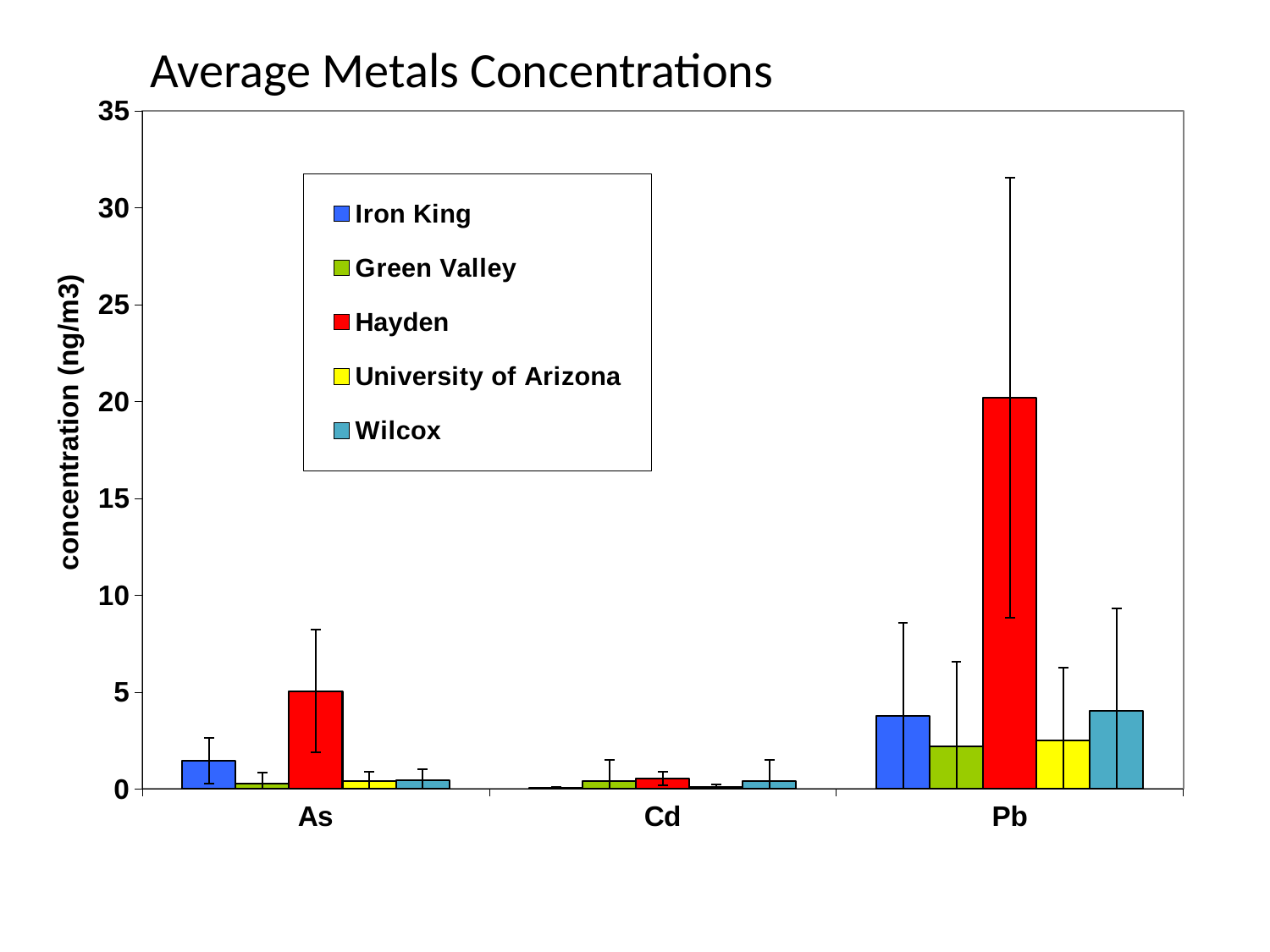
Which is larger, the Pb concentration for Hayden or for Wilcox? Hayden Which site has the highest As concentration? Hayden How many series does the legend list? 5 Which is larger, the As concentration for Iron King or for Green Valley? Iron King How many metal categories are shown on the x axis? 3 Is the As concentration for Hayden greater or less than 10? less What is the label on the y axis? concentration (ng/m3) What kind of chart is shown on the slide? bar chart Is the Pb concentration for Hayden greater or less than 15? greater Which site has the highest Pb concentration? Hayden What is the title of the chart? Average Metals Concentrations Is the Pb concentration for Iron King greater or less than 5? less